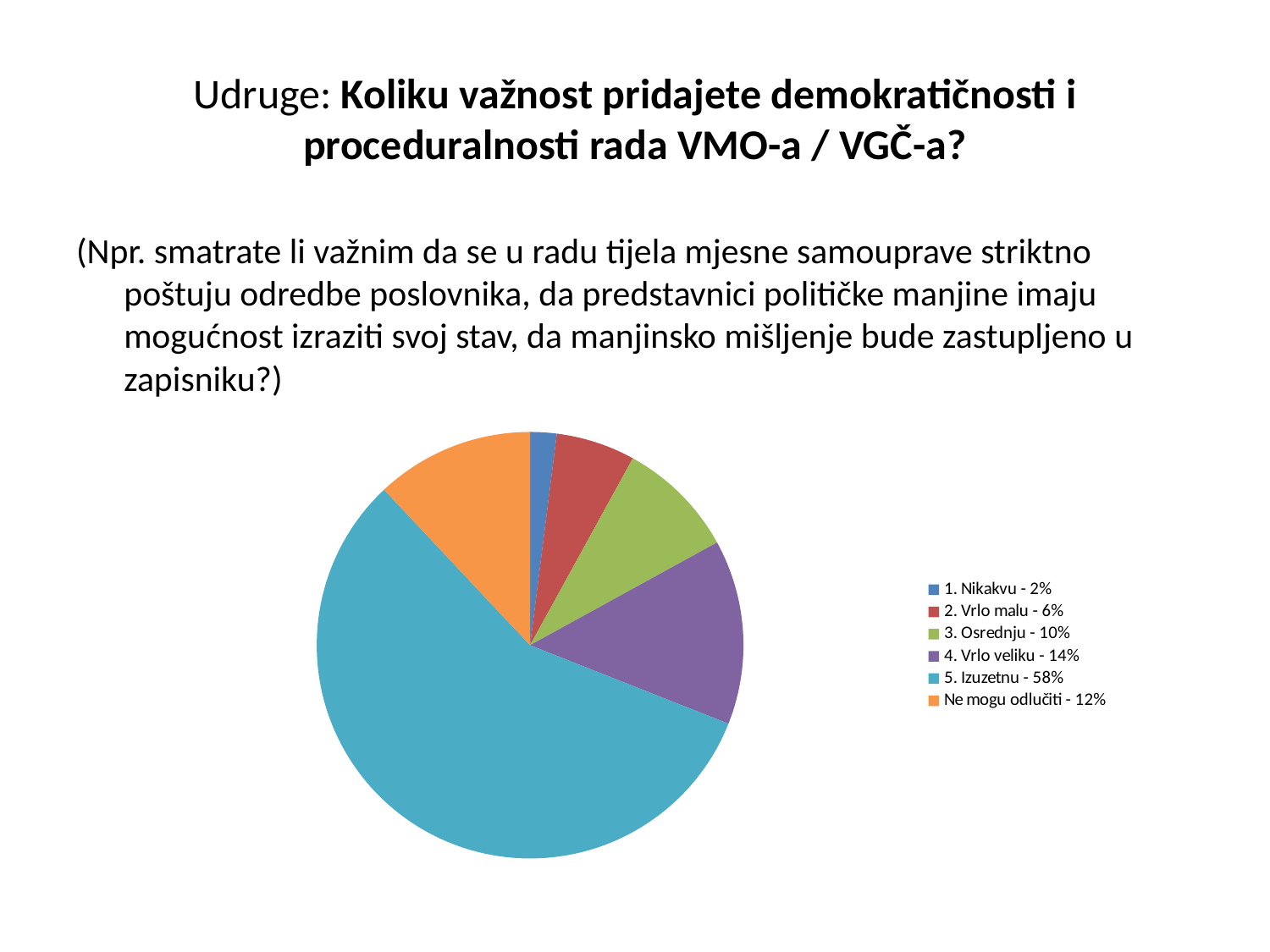
What colour is the slice for "5. Izuzetnu"? teal/light blue What percentage is shown for "Ne mogu odlučiti"? 12% What share of the pie does "5. Izuzetnu" represent? 58% Which is larger, the share for "2. Vrlo malu" or the share for "Ne mogu odlučiti"? Ne mogu odlučiti Which category has the smallest share of the pie? 1. Nikakvu Which category has the largest share of the pie? 5. Izuzetnu What is the difference in percentage points between "5. Izuzetnu" and "4. Vrlo veliku"? 44 How many slices does the pie chart have? 6 What is the combined share of "4. Vrlo veliku" and "5. Izuzetnu"? 72% What kind of chart is shown on the slide? pie chart What share of the pie does "1. Nikakvu" represent? 2% What percentage is shown for "3. Osrednju"? 10%